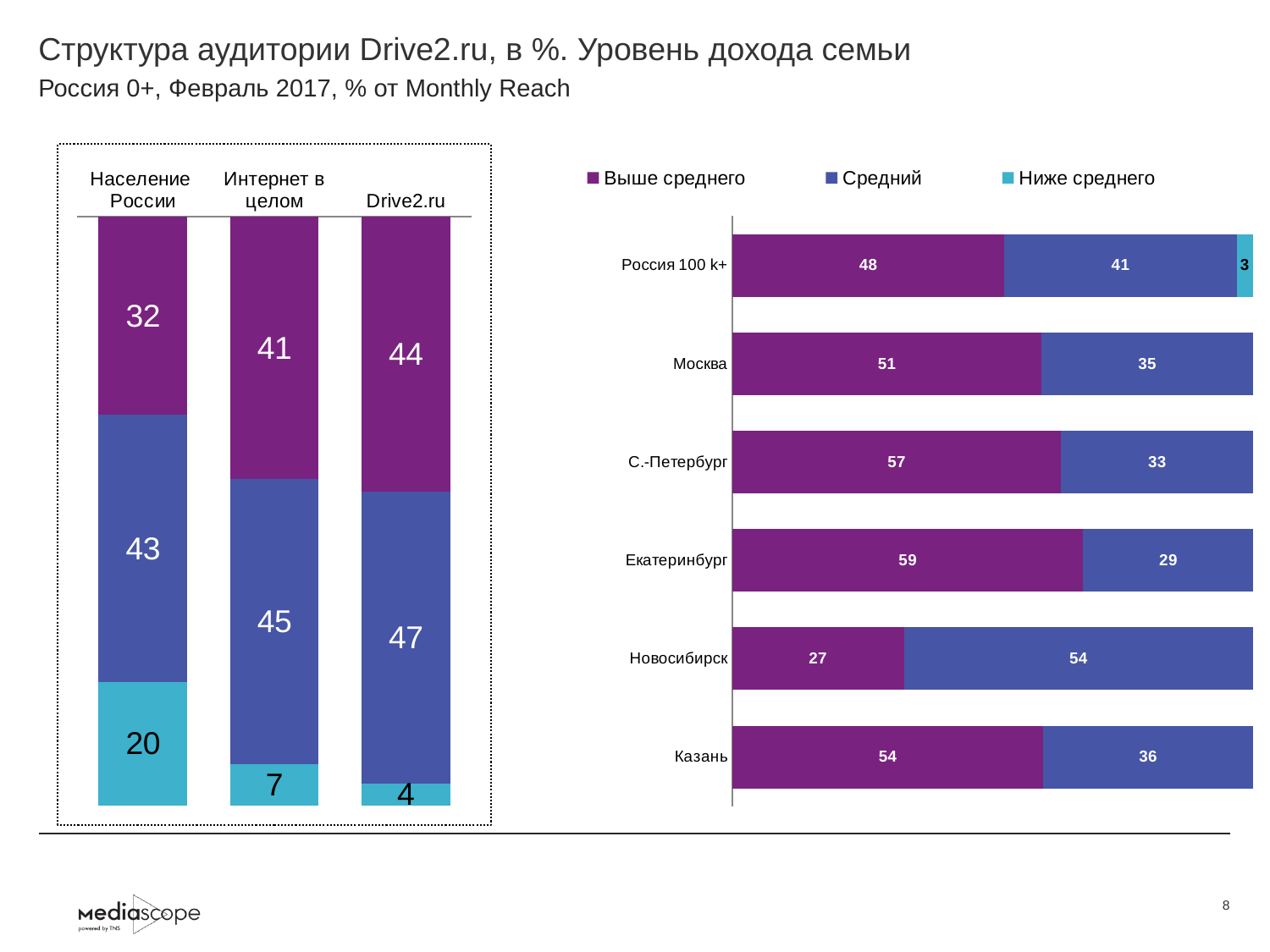
In the right chart, what is the difference between the Выше среднего values for Москва and С.-Петербург? 6 In the left chart, what is the total of the three segments for Интернет в целом? 93 What type of chart is the right chart? Stacked bar chart In the right chart, which category has the lowest Выше среднего value? Новосибирск In the right chart, what is the value of the Средний segment for Новосибирск? 54 In the left chart, which is larger: the middle (blue) segment for Интернет в целом or for Drive2.ru? Drive2.ru How many categories are shown in the right chart? 6 In the left chart, what is the value of the bottom (light blue) segment for Население России? 20 In the left chart, what is the value of the top (purple) segment for Drive2.ru? 44 How many series does the legend of the right chart list? 3 In the right chart, which city has the highest Выше среднего value? Екатеринбург In the right chart, what is the value of the Выше среднего segment for Екатеринбург? 59